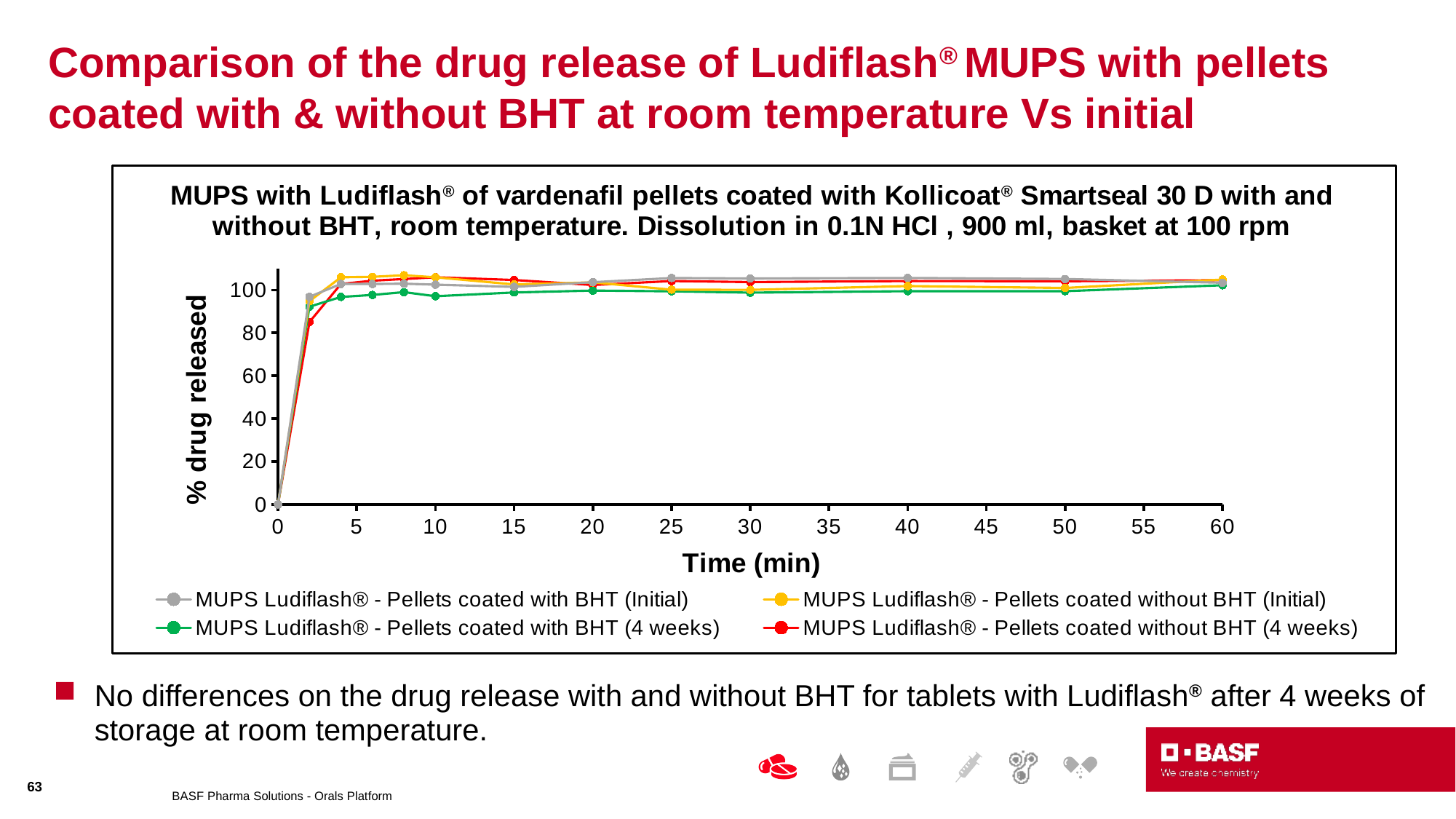
Is the value for MUPS Ludiflash® - Pellets coated without BHT (4 weeks) at 2 min greater or less than 100? less How many series does the chart legend list? 4 Which colour represents MUPS Ludiflash® - Pellets coated with BHT (4 weeks)? green How many time points are plotted for each series? 13 Is the value for MUPS Ludiflash® - Pellets coated with BHT (4 weeks) at 2 min greater or less than 100? less What is the label of the x axis? Time (min) What is the % drug released for all series at 0 min? 0 What kind of chart is shown on the slide? line chart Is the value for MUPS Ludiflash® - Pellets coated with BHT (Initial) at 10 min greater or less than 80? greater How do the values change along the x axis from 0 min to 60 min? They rise sharply then plateau What is the label of the y axis? % drug released At 2 min, which series has the higher value: MUPS Ludiflash® - Pellets coated with BHT (Initial) or MUPS Ludiflash® - Pellets coated without BHT (4 weeks)? MUPS Ludiflash® - Pellets coated with BHT (Initial)